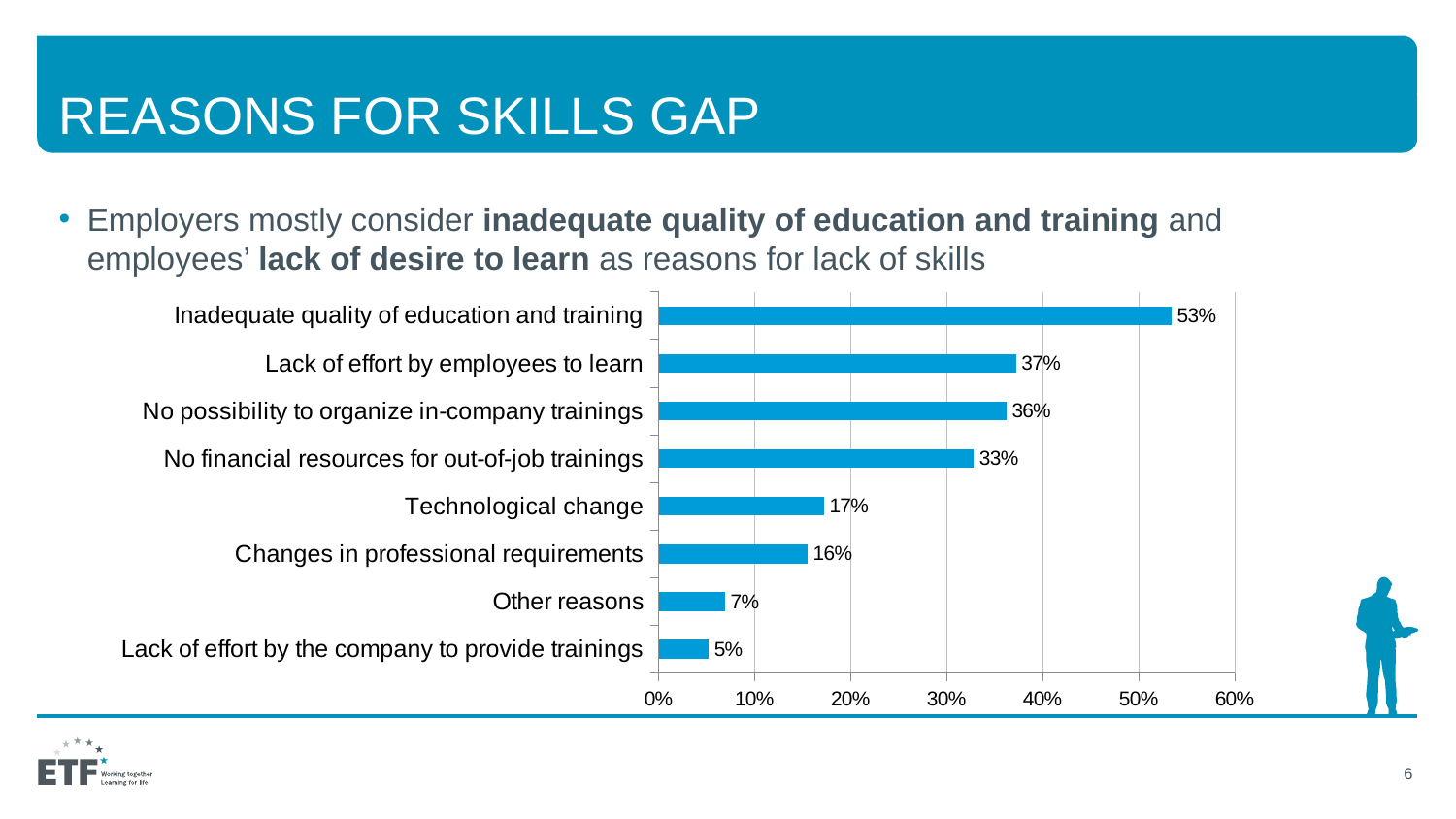
What is the difference between "Inadequate quality of education and training" and "Lack of effort by employees to learn"? 16% Is the value for "No possibility to organize in-company trainings" greater or less than 30%? greater What is the value for "Lack of effort by the company to provide trainings"? 5% How many reasons are shown in the chart? 8 Which reason has the lowest value? Lack of effort by the company to provide trainings Which is larger: "No financial resources for out-of-job trainings" or "Technological change"? No financial resources for out-of-job trainings What is the maximum value shown on the horizontal axis? 60% What is the value for "Inadequate quality of education and training"? 53% What is the difference between "Other reasons" and "Lack of effort by the company to provide trainings"? 2% Which reason has the highest value? Inadequate quality of education and training What is the value for "Technological change"? 17% What kind of chart is shown on the slide? Bar chart